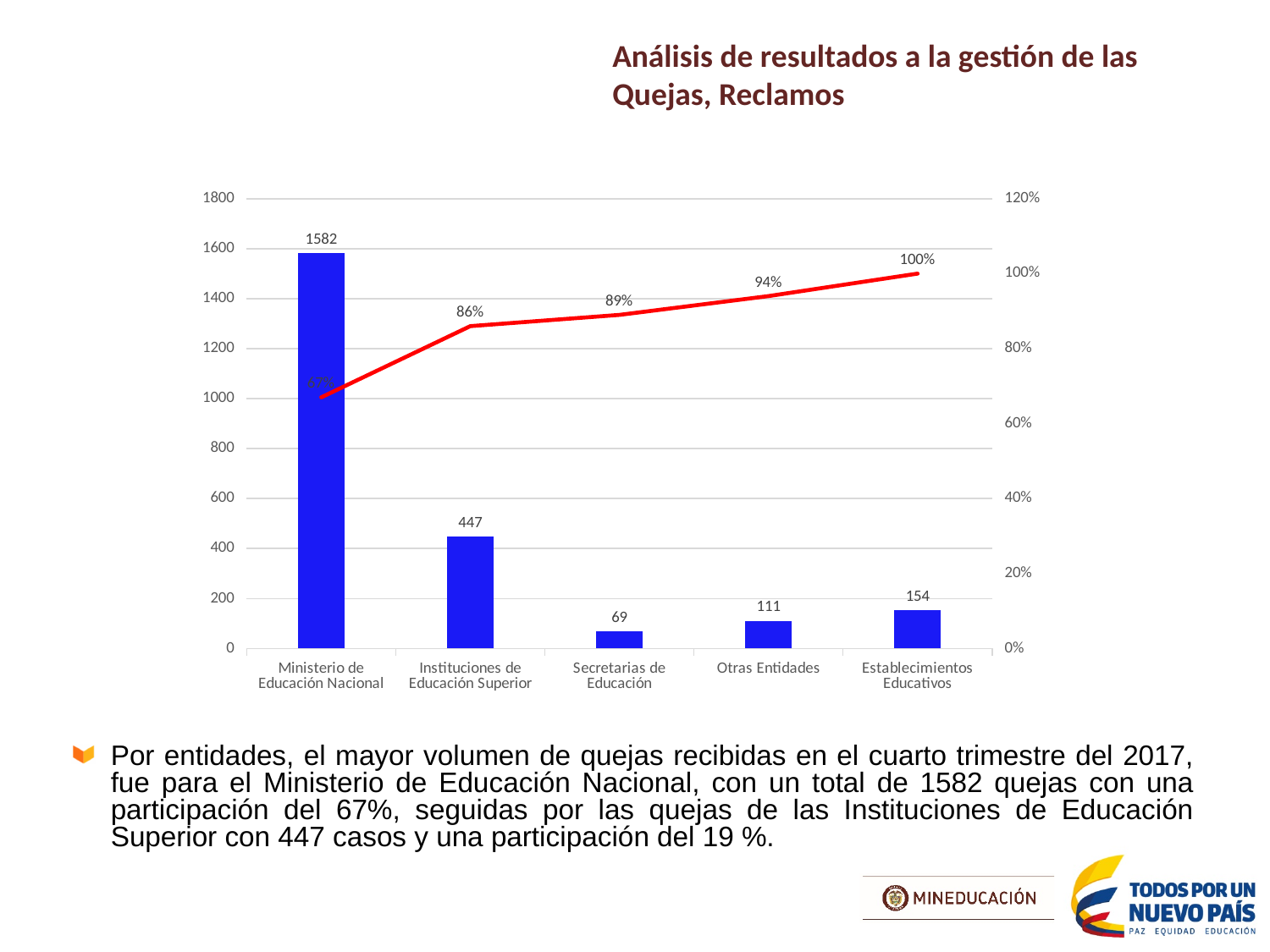
Which category has the lowest bar? Secretarias de Educación Which is larger, the bar for Establecimientos Educativos or the bar for Otras Entidades? Establecimientos Educativos Does the red line rise or fall from left to right across the categories? Rise How many categories are shown on the x axis? 5 What is the cumulative percentage shown at Establecimientos Educativos? 100% What is the value of the bar for Instituciones de Educación Superior? 447 What is the number of complaints for Ministerio de Educación Nacional? 1582 What kind of chart is shown on the slide? Bar chart with a line What is the difference between the bar values for Ministerio de Educación Nacional and Instituciones de Educación Superior? 1135 What cumulative percentage does the line show for Otras Entidades? 94% Which category has the highest bar? Ministerio de Educación Nacional What is the value of the bar for Secretarias de Educación? 69